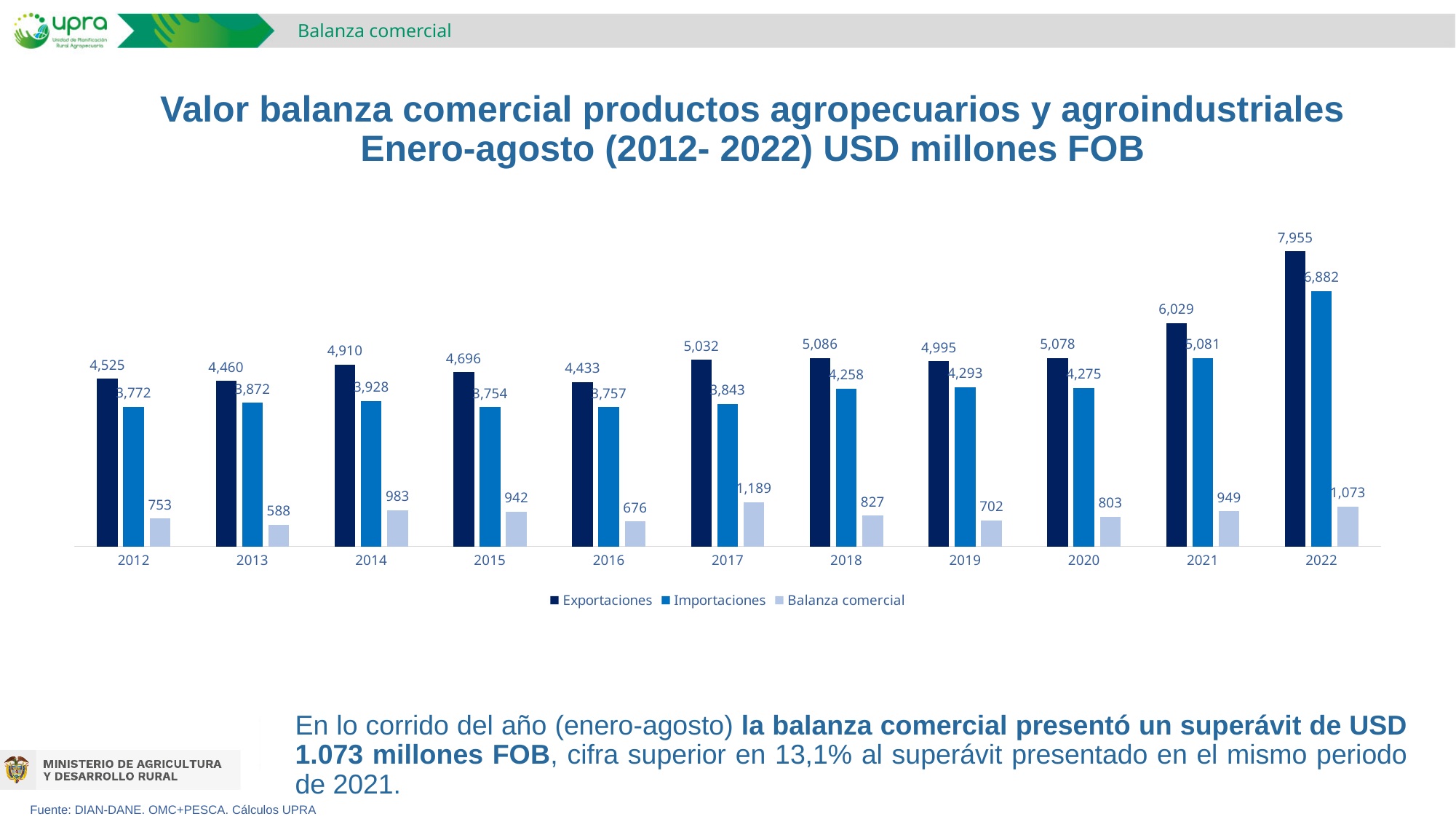
What type of chart is shown on the slide? bar chart What is the value of Exportaciones for 2016? 4,433 Do the Exportaciones values rise or fall from 2020 to 2022? rise Which series is shown in the lightest colour in the legend? Balanza comercial Which is larger, the Balanza comercial value for 2014 or for 2015? 2014 What is the difference between Exportaciones in 2022 and Exportaciones in 2021? 1,926 How many years are shown on the x axis? 11 Which year has the highest Exportaciones value? 2022 What is the value of Exportaciones for 2022? 7,955 How many series does the legend list? 3 What is the value of Balanza comercial for 2017? 1,189 Which year has the lowest Balanza comercial value? 2013